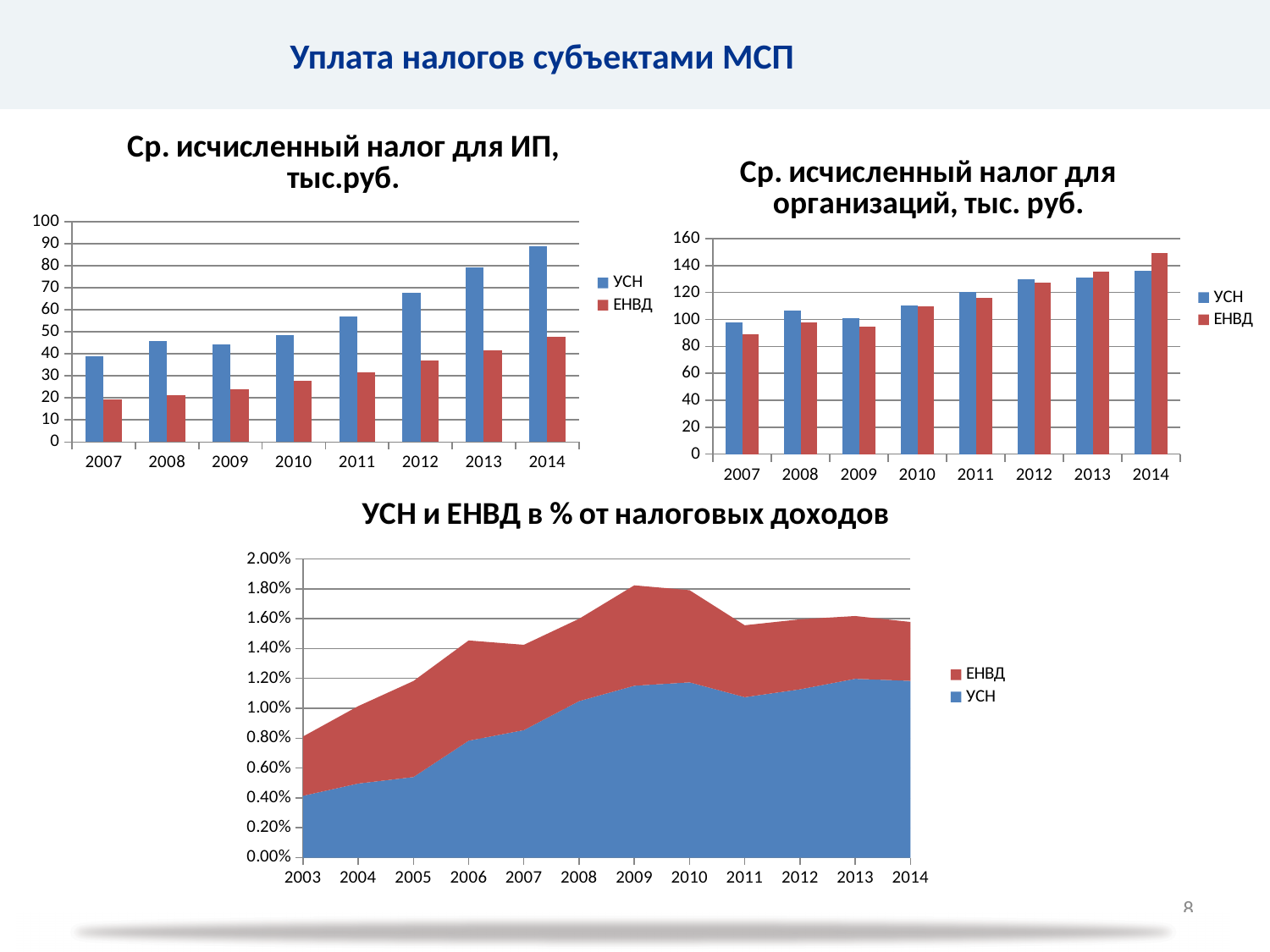
In the chart titled "Ср. исчисленный налог для ИП, тыс.руб.", which year has the lowest ЕНВД value? 2007 What kind of chart is the chart titled "Ср. исчисленный налог для ИП, тыс.руб."? bar chart What kind of chart is the chart titled "УСН и ЕНВД в % от налоговых доходов"? stacked area chart How many series does the legend of the chart titled "Ср. исчисленный налог для организаций, тыс. руб." list? 2 In the chart titled "Ср. исчисленный налог для организаций, тыс. руб.", is the ЕНВД value for 2007 greater or less than 100? less In the chart titled "Ср. исчисленный налог для ИП, тыс.руб.", do the УСН values generally rise or fall from 2007 to 2014? rise In the chart titled "Ср. исчисленный налог для ИП, тыс.руб.", is the УСН value for 2014 greater or less than 80? greater In the chart titled "Ср. исчисленный налог для организаций, тыс. руб.", which year has the highest ЕНВД value? 2014 In the chart titled "УСН и ЕНВД в % от налоговых доходов", how many years are shown on the x axis? 12 In the chart titled "Ср. исчисленный налог для организаций, тыс. руб.", which is larger in 2014, УСН or ЕНВД? ЕНВД In the chart titled "Ср. исчисленный налог для ИП, тыс.руб.", how many years are shown on the x axis? 8 In the chart titled "Ср. исчисленный налог для ИП, тыс.руб.", which year has the highest УСН value? 2014